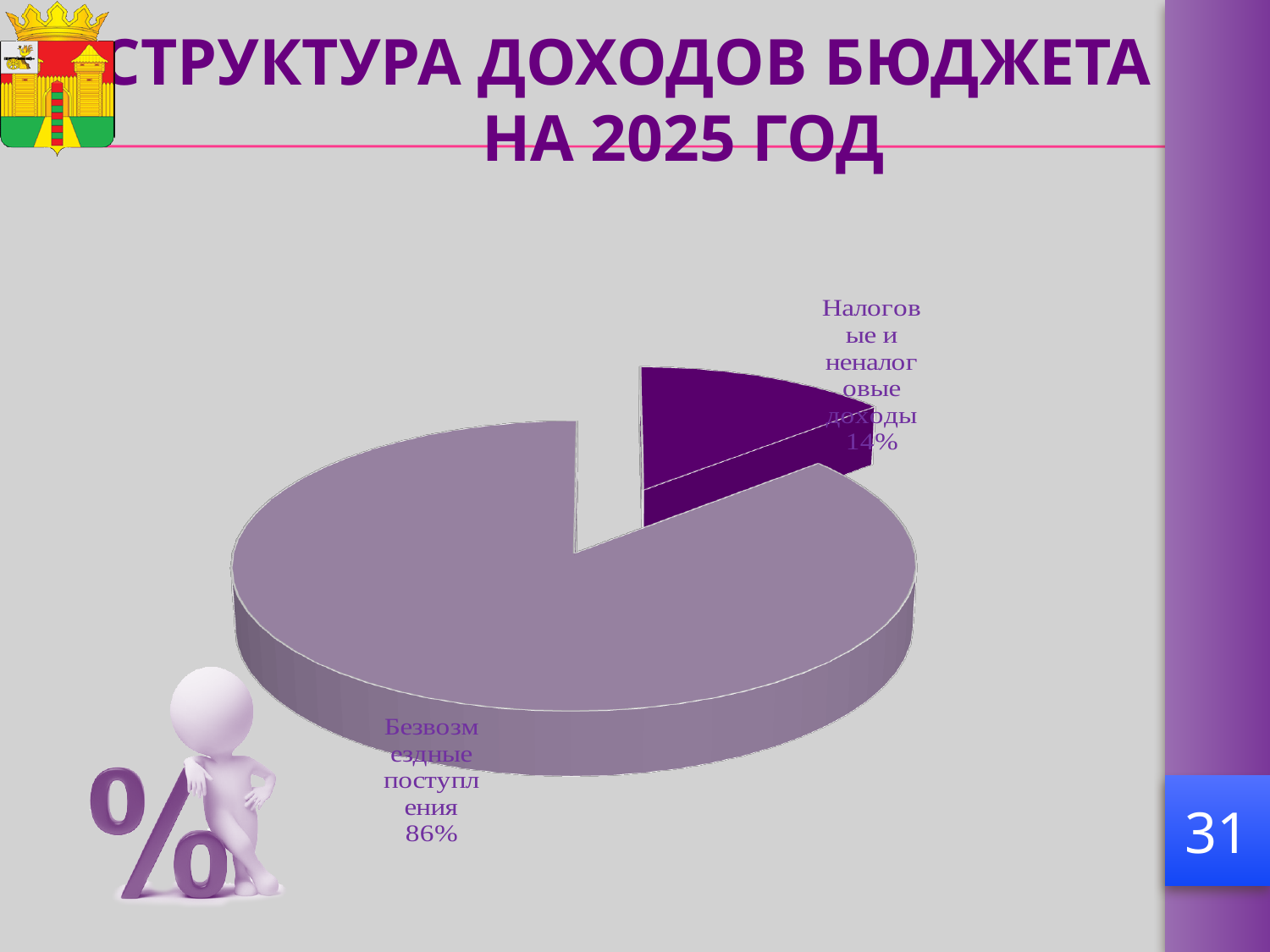
What share of the pie does "Налоговые и неналоговые доходы" represent? 14% Which slice of the pie is pulled out (exploded) from the rest? Налоговые и неналоговые доходы What kind of chart is shown on the slide? Pie chart What is the difference in percentage points between "Безвозмездные поступления" and "Налоговые и неналоговые доходы"? 72 What is the title of the slide containing the pie chart? СТРУКТУРА ДОХОДОВ БЮДЖЕТА НА 2025 ГОД Which is larger: the share of "Безвозмездные поступления" or the share of "Налоговые и неналоговые доходы"? Безвозмездные поступления How many slices does the pie chart have? 2 Which category has the smallest slice of the pie? Налоговые и неналоговые доходы What share of the pie does "Безвозмездные поступления" represent? 86% Which category has the largest slice of the pie? Безвозмездные поступления